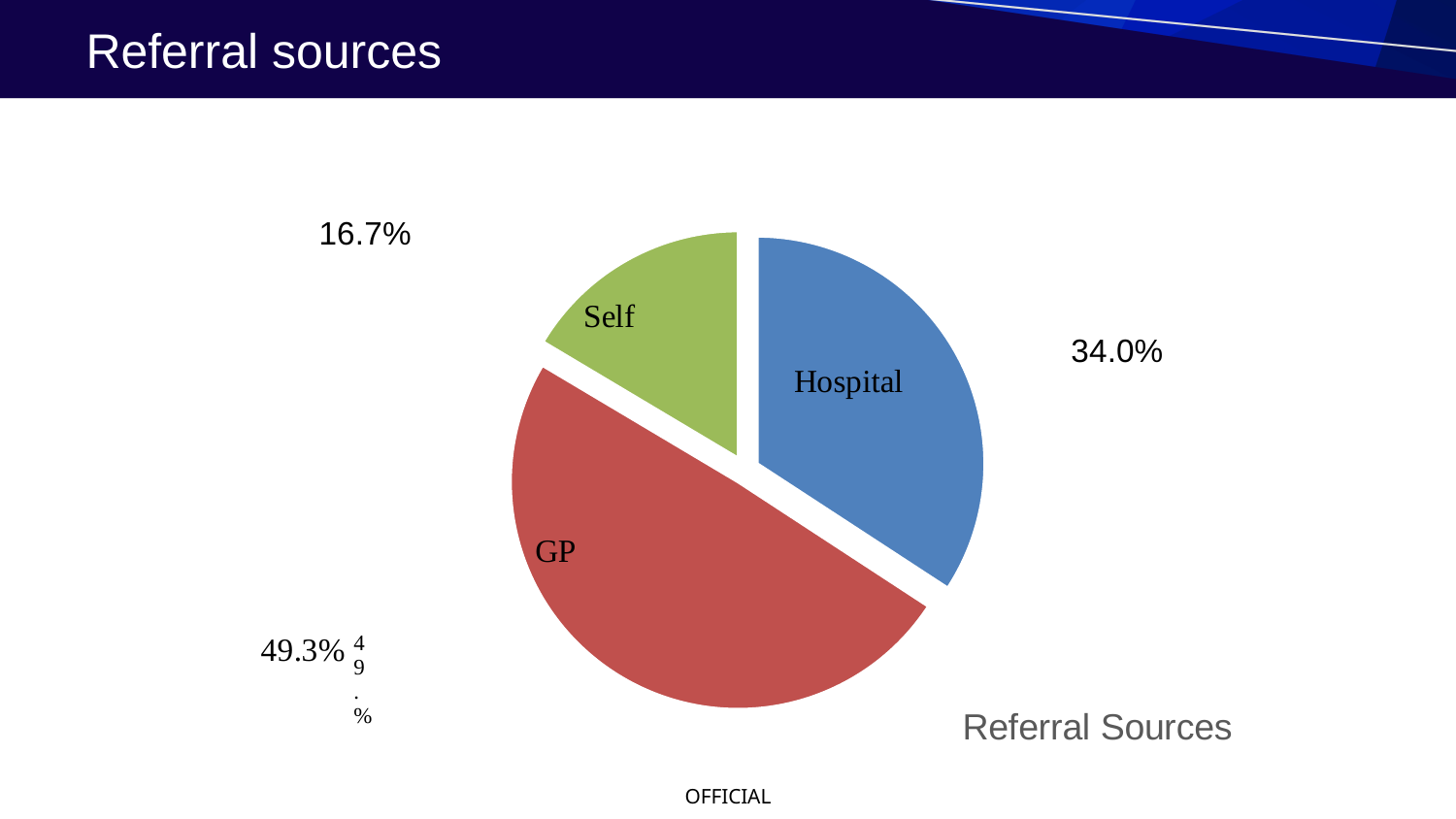
What is the title of the chart? Referral Sources How many slices does the pie chart have? 3 Which is larger, the Hospital share or the Self share? Hospital What colour is the GP slice? red What is the difference in percentage points between the GP share and the Hospital share? 15.3 What share of referrals comes from GP? 49.3% What is the difference in percentage points between the Hospital share and the Self share? 17.3 Which referral source has the largest share? GP Which referral source has the smallest share? Self What type of chart is shown on the slide? pie chart What share of referrals comes from Self? 16.7% What share of referrals comes from Hospital? 34.0%